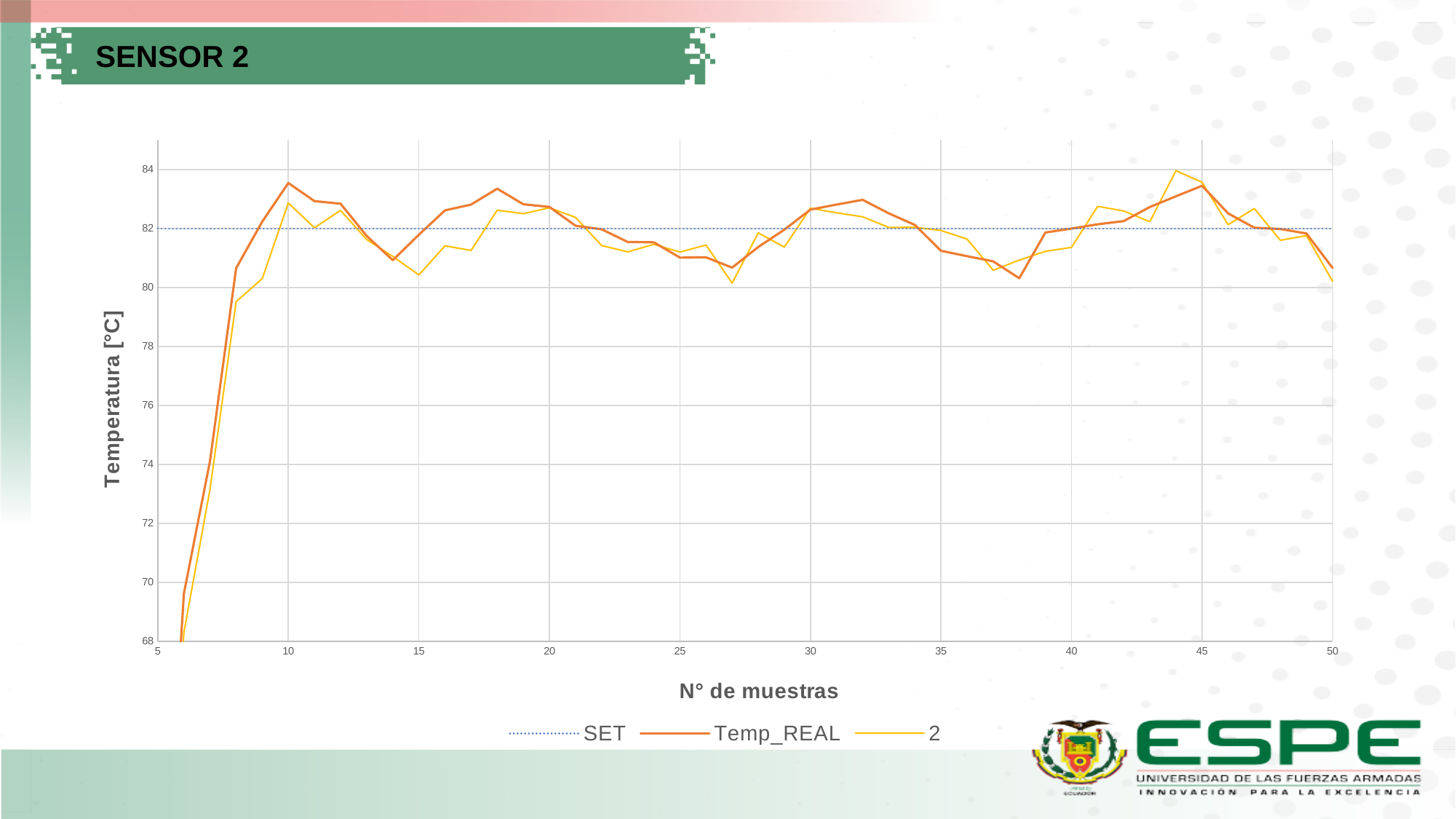
Is the value of Temp_REAL at sample 10 greater or less than 82? greater What is the label of the y axis? Temperatura [°C] Is the value of series 2 at sample 15 greater or less than 82? less At what temperature is the SET line drawn? 82 Is the value of series 2 at sample 44 greater or less than 82? greater At sample 9, which series has the higher value, Temp_REAL or 2? Temp_REAL How many series does the legend list? 3 What are the series names listed in the legend? SET, Temp_REAL, 2 What kind of chart is shown on the slide? line chart Does the Temp_REAL line rise or fall between sample 6 and sample 10? rise